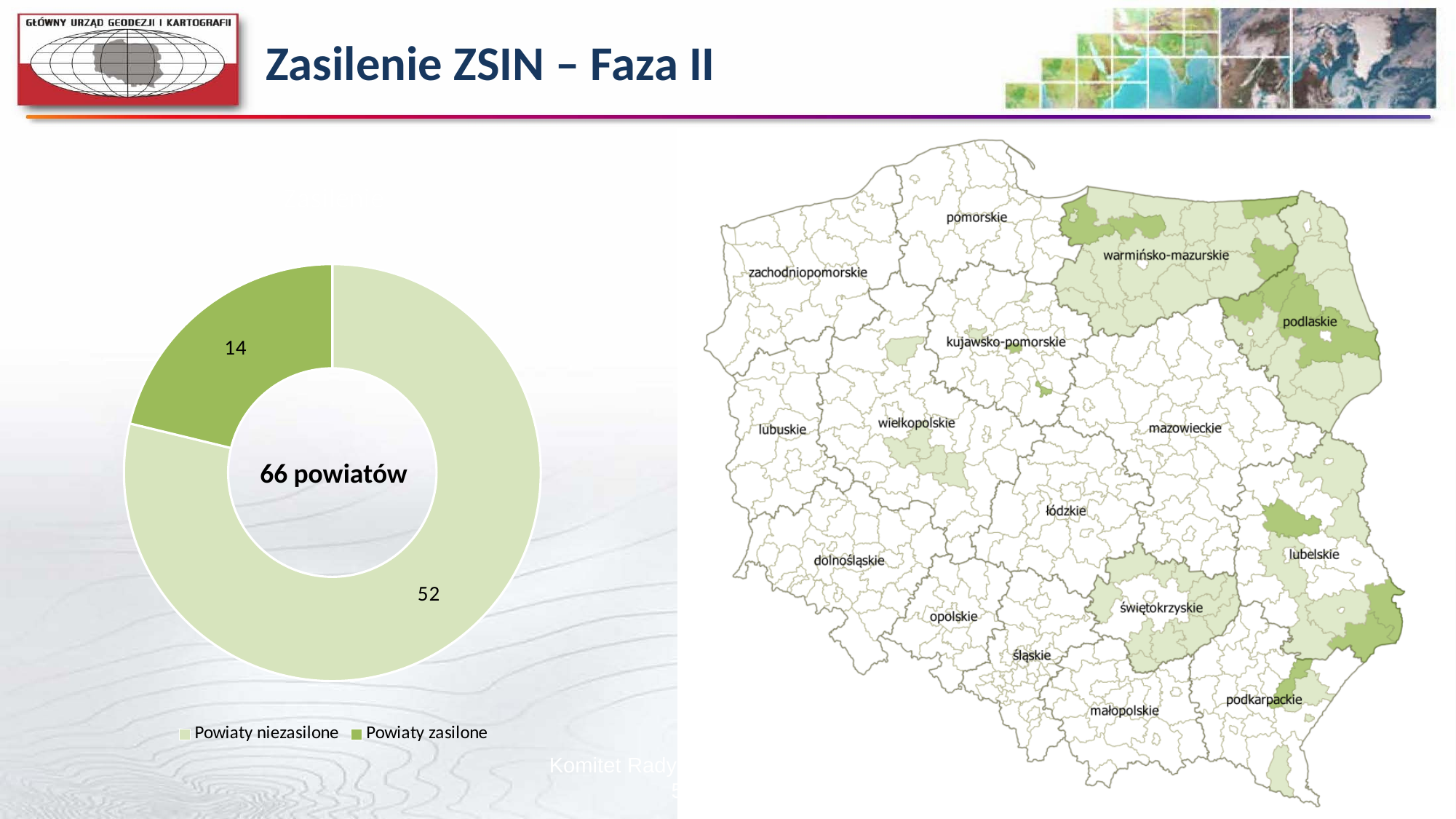
What type of chart is shown on the left of the slide? doughnut chart How many categories does the doughnut chart have? 2 Which category in the doughnut chart has the larger value? Powiaty niezasilone Which legend entry of the doughnut chart is shown in the darker green colour? Powiaty zasilone Is the value for Powiaty niezasilone larger or smaller than the value for Powiaty zasilone? larger In the doughnut chart, what is the value for Powiaty zasilone? 14 What is the difference between the values for Powiaty niezasilone and Powiaty zasilone in the doughnut chart? 38 Which category in the doughnut chart has the smaller value? Powiaty zasilone In the doughnut chart, what is the value for Powiaty niezasilone? 52 What total is shown in the centre of the doughnut chart? 66 powiatów What share of the 66 powiatów in the doughnut chart are Powiaty zasilone? 21.2% How many entries does the legend of the doughnut chart list? 2